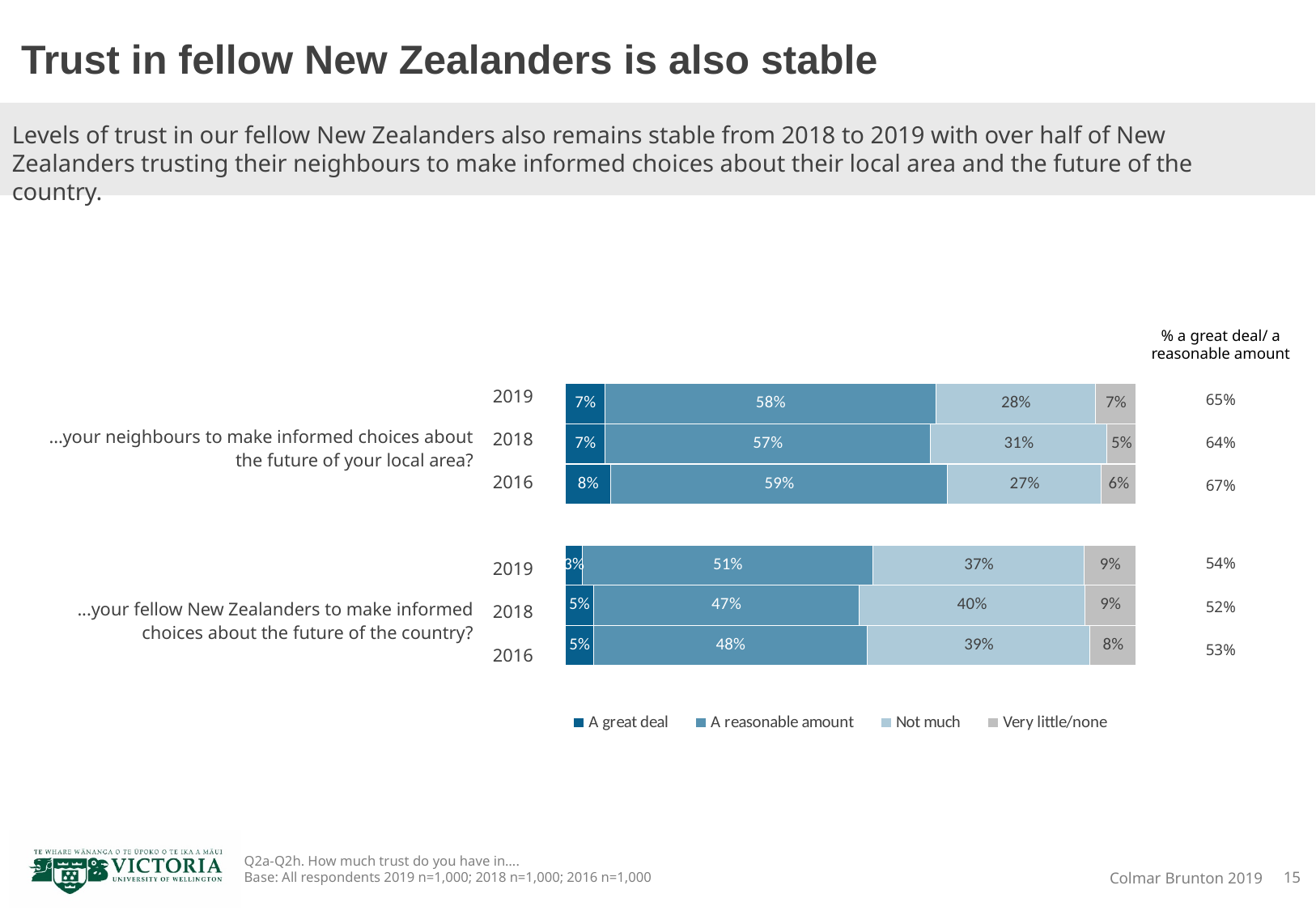
Which year has the highest '% a great deal/ a reasonable amount' for trust in neighbours to make informed choices about the local area? 2016 How many series does the legend list? 4 What is the 'Very little/none' percentage for trust in fellow New Zealanders to make informed choices about the future of the country in 2016? 8% What percentage of respondents in 2019 said they have 'A reasonable amount' of trust in their neighbours to make informed choices about the future of their local area? 58% What percentage of respondents in 2018 said 'Not much' trust in their fellow New Zealanders to make informed choices about the future of the country? 40% What kind of chart is shown on the slide? Stacked bar chart How many years are shown for each question in the chart? 3 What is the difference between the 'Not much' percentages for trust in neighbours in 2018 and 2019? 3% Which year has the lowest '% a great deal/ a reasonable amount' for trust in fellow New Zealanders to make informed choices about the future of the country? 2018 What is the combined '% a great deal/ a reasonable amount' figure for trust in neighbours to make informed choices about the local area in 2016? 67% Is the 'A reasonable amount' percentage for trust in neighbours in 2019 larger or smaller than the 'A reasonable amount' percentage for trust in fellow New Zealanders in 2019? Larger What is the combined '% a great deal/ a reasonable amount' figure for trust in fellow New Zealanders to make informed choices about the future of the country in 2019? 54%